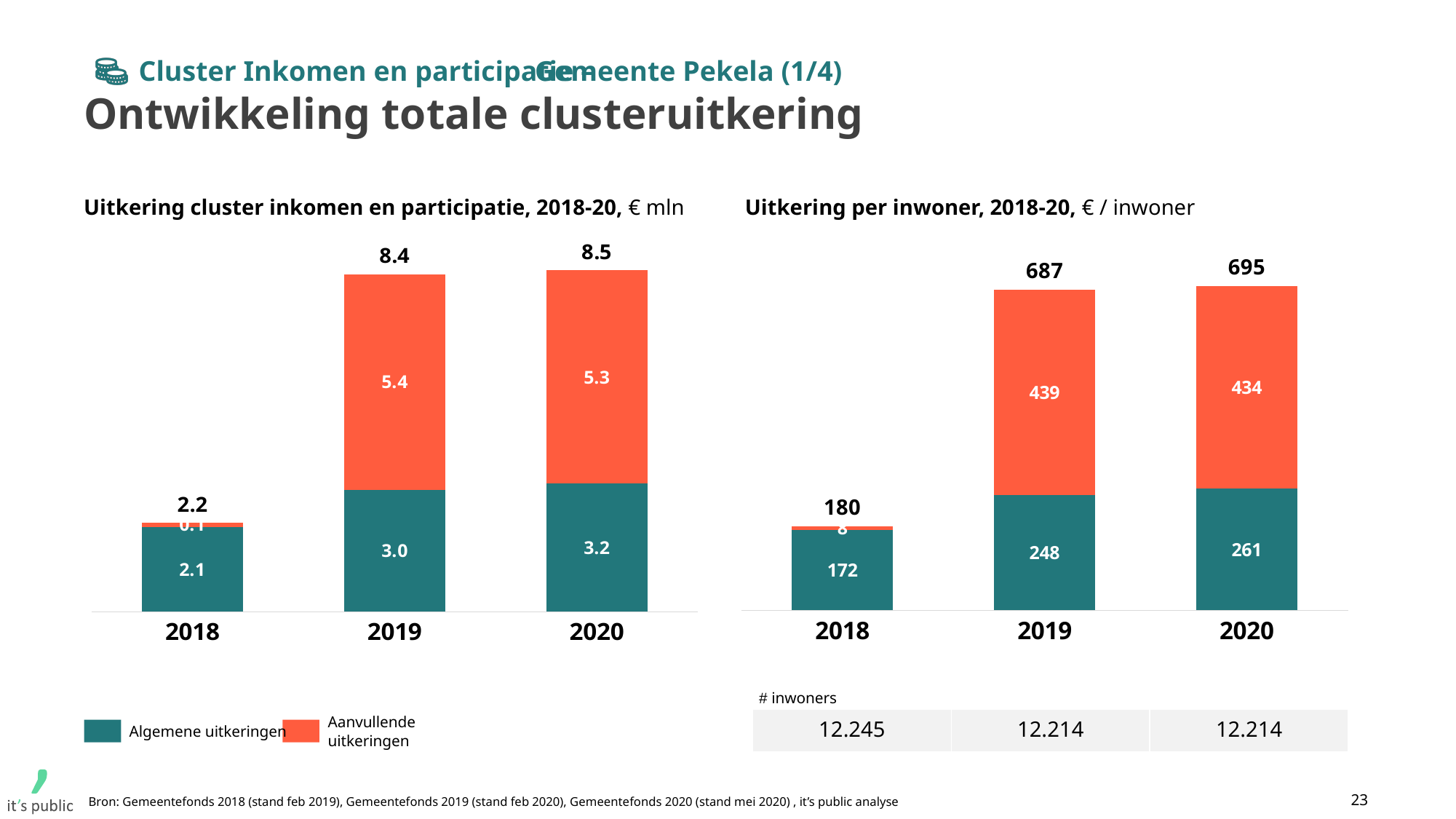
In the right chart 'Uitkering per inwoner, 2018-20', which year has the lowest total? 2018 In the right chart 'Uitkering per inwoner, 2018-20', what is the value of Aanvullende uitkeringen for 2019? 439 In the right chart 'Uitkering per inwoner, 2018-20', what is the value of Algemene uitkeringen for 2020? 261 In the left chart 'Uitkering cluster inkomen en participatie, 2018-20', what is the difference between the Aanvullende uitkeringen values for 2019 and 2020? 0.1 What kind of chart is the left chart 'Uitkering cluster inkomen en participatie, 2018-20'? Stacked bar chart In the left chart 'Uitkering cluster inkomen en participatie, 2018-20', what is the value of Aanvullende uitkeringen for 2020? 5.3 In the right chart 'Uitkering per inwoner, 2018-20', what is the total of the stacked bar for 2020? 695 In the left chart 'Uitkering cluster inkomen en participatie, 2018-20', which year has the highest total? 2020 In the left chart 'Uitkering cluster inkomen en participatie, 2018-20', what is the total of the stacked bar for 2018? 2.2 How many series does the legend list for the left chart 'Uitkering cluster inkomen en participatie, 2018-20'? 2 In the left chart 'Uitkering cluster inkomen en participatie, 2018-20', what is the value of Algemene uitkeringen for 2019? 3.0 In the right chart 'Uitkering per inwoner, 2018-20', what is the difference between the totals for 2019 and 2018? 507